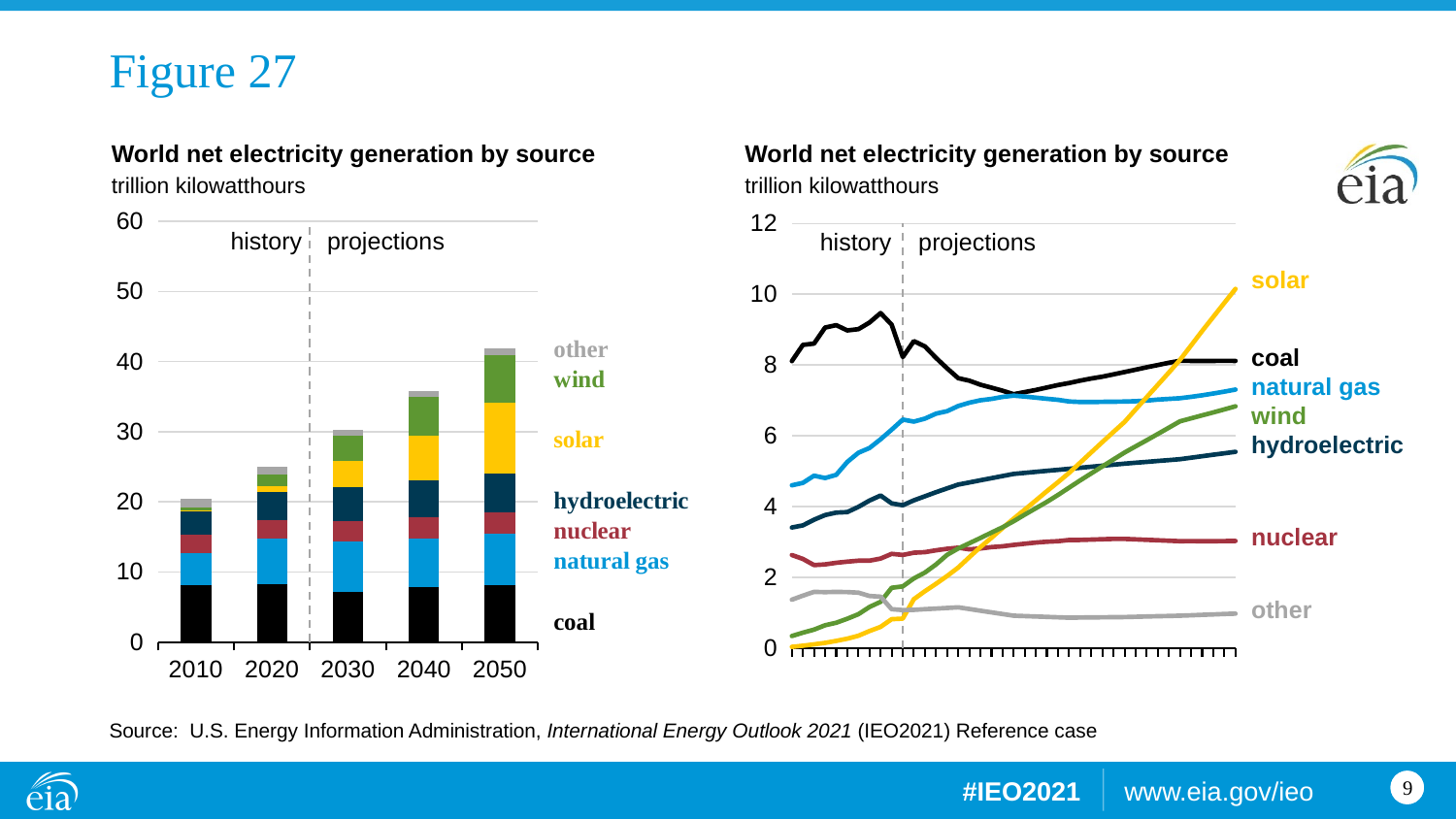
In the right chart, does the solar line rise or fall over the projection period? rise What kind of chart is the chart on the right side of the slide? line chart In the right chart, is the value for nuclear at the end of the projection period greater or less than 2? greater In the left chart, is the total bar for 2050 greater or less than 40? greater In the right chart, which source has the lowest value at the end of the projection period? other In the right chart, which source has the highest value at the end of the projection period? solar In the left chart, how many years are shown on the x axis? 5 In the left chart, is the total bar for 2040 greater or less than 30? greater In the left chart, which year has the tallest total bar? 2050 What kind of chart is the chart on the left side of the slide? bar chart In the left chart, how many sources are stacked in each bar? 7 In the left chart, which year has the shortest total bar? 2010